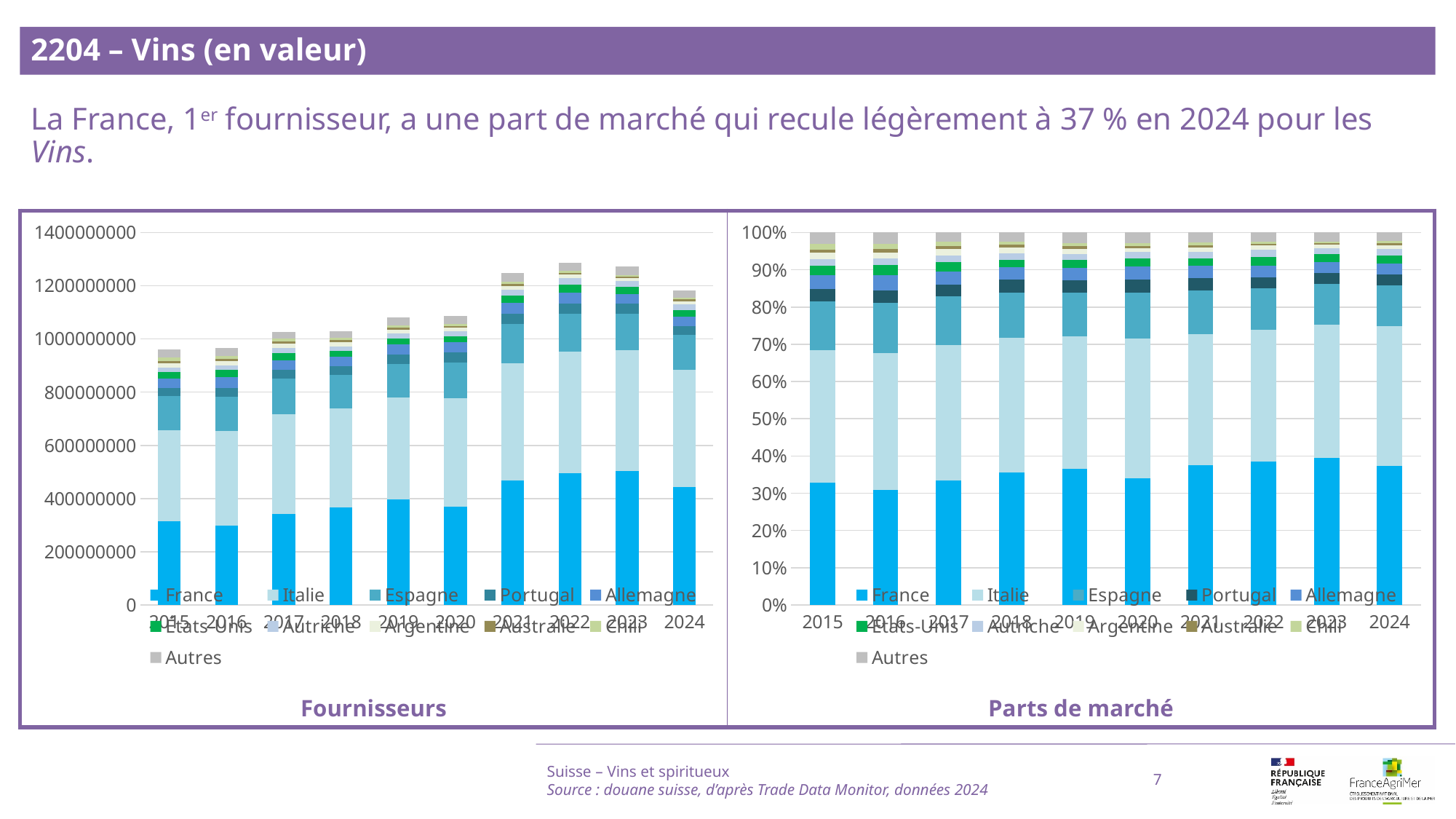
What kind of chart is the 'Fournisseurs' chart on the left? stacked bar chart In the 'Fournisseurs' chart, is the France segment for 2024 greater or less than 400000000? greater How many years are shown on the x axis of the 'Parts de marché' chart? 10 What is the title shown under the right-hand chart? Parts de marché Which series is listed first in the legend of the 'Parts de marché' chart? France In the 'Parts de marché' chart, is the France share for 2015 greater or less than 40%? less In the 'Fournisseurs' chart, is the total stacked value for 2024 greater or less than 1000000000? greater How many series does the legend of the 'Fournisseurs' chart list? 11 In the 'Fournisseurs' chart, which is larger, the France segment for 2015 or for 2023? 2023 In the 'Fournisseurs' chart, does the France segment generally rise or fall from 2015 to 2023? rise